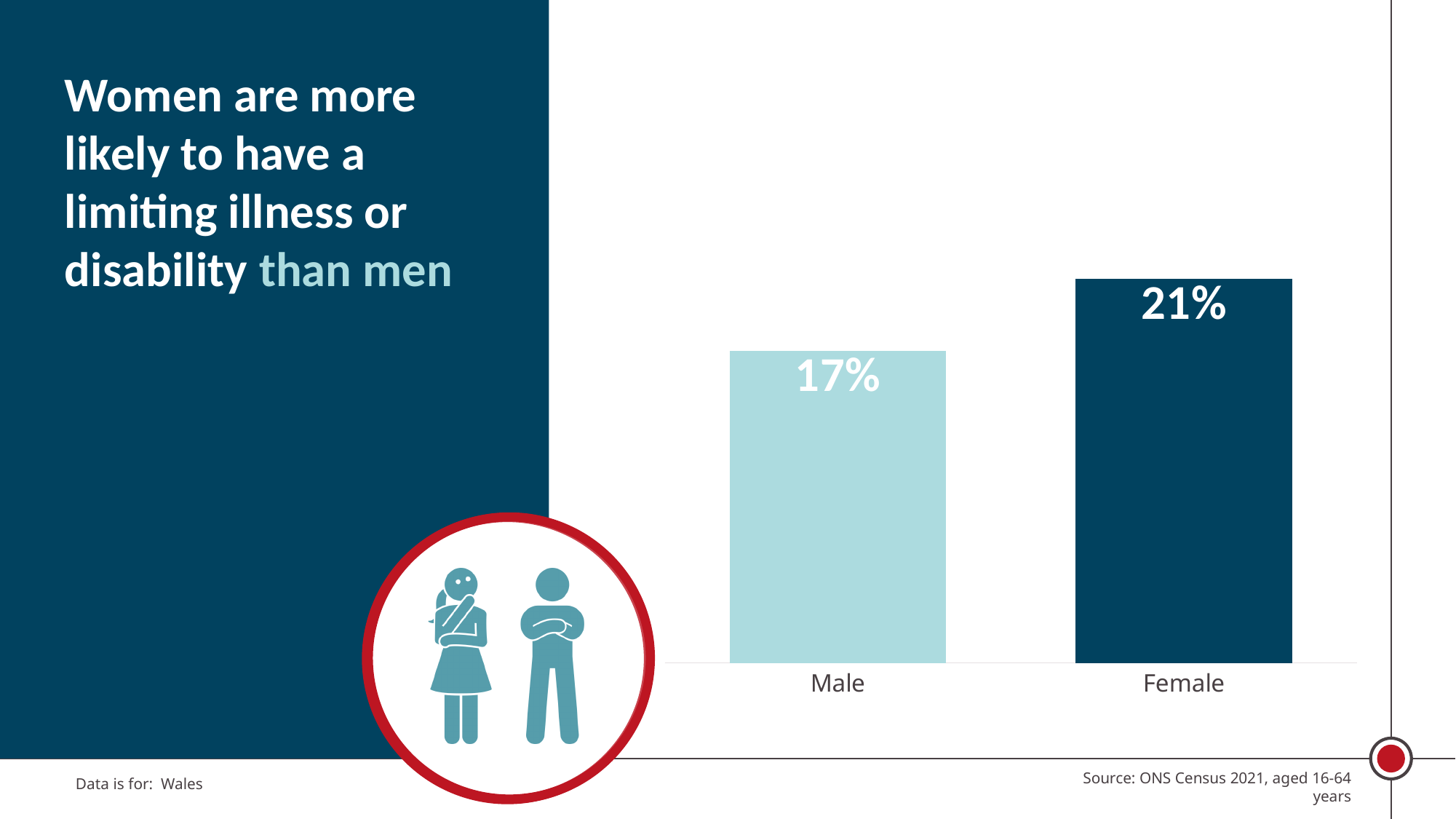
Which is larger, the value for Male or the value for Female? Female Which category has the highest value? Female Which bar is drawn in the darker blue colour? Female According to the slide, which area is the data for? Wales What is the difference between the Female and Male values? 4% Do the values rise or fall from Male to Female? Rise How many categories are shown on the chart? 2 What is the value for Male? 17% What kind of chart is shown on the slide? Bar chart Which category has the lowest value? Male What is the value for Female? 21%